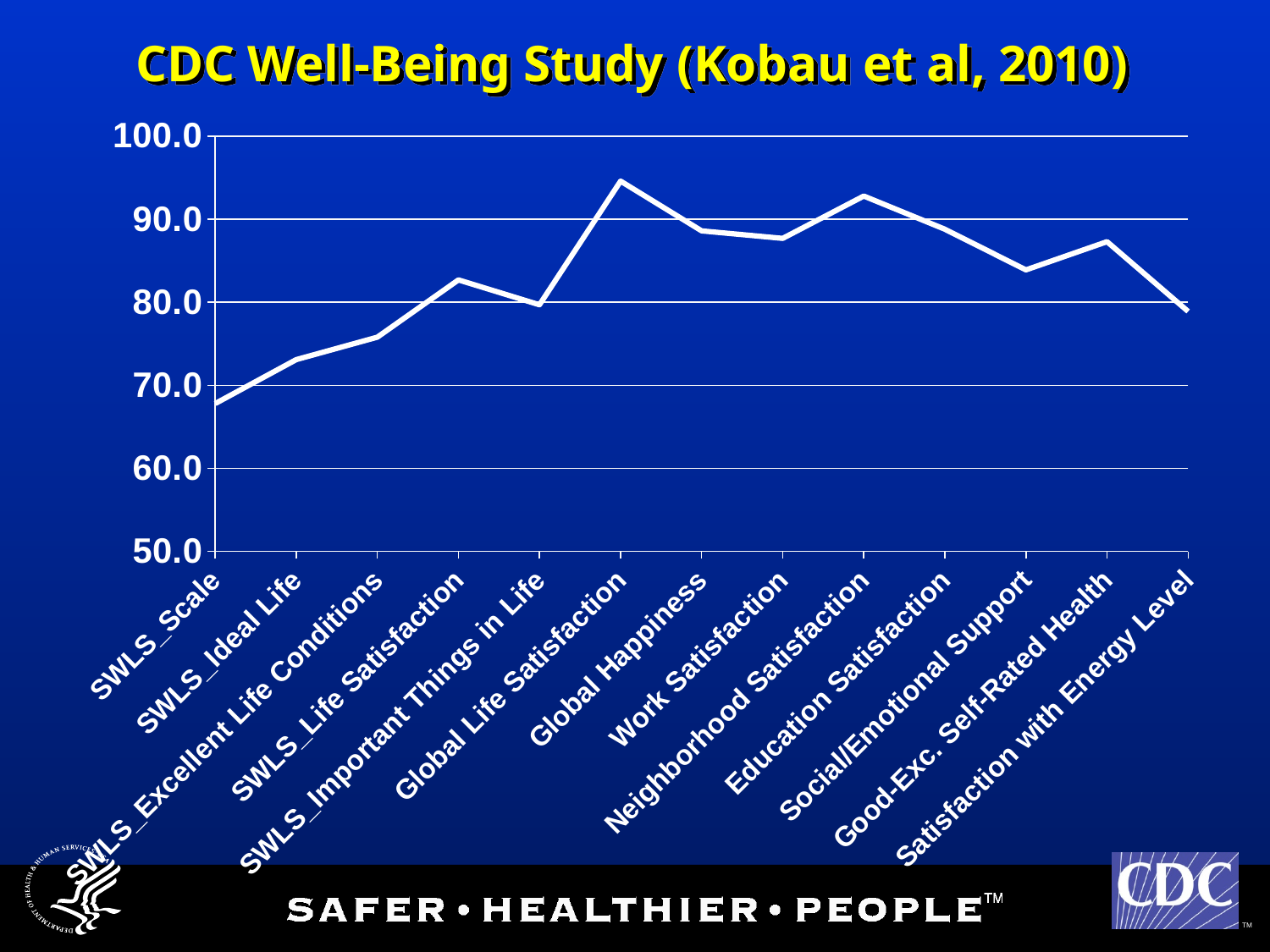
What kind of chart is shown on the slide? line chart Is the value for Global Life Satisfaction greater or less than 90.0? greater Which category has the lowest value? SWLS_Scale What is the title of the chart? CDC Well-Being Study (Kobau et al, 2010) Is the value for Social/Emotional Support greater or less than 90.0? less Which is larger, the value for Global Happiness or the value for Satisfaction with Energy Level? Global Happiness Which category has the highest value? Global Life Satisfaction How many categories are plotted along the x axis? 13 Which is larger, the value for SWLS_Ideal Life or the value for SWLS_Life Satisfaction? SWLS_Life Satisfaction Is the value for SWLS_Scale greater or less than 70.0? less Do the values rise or fall from SWLS_Scale to SWLS_Life Satisfaction? rise